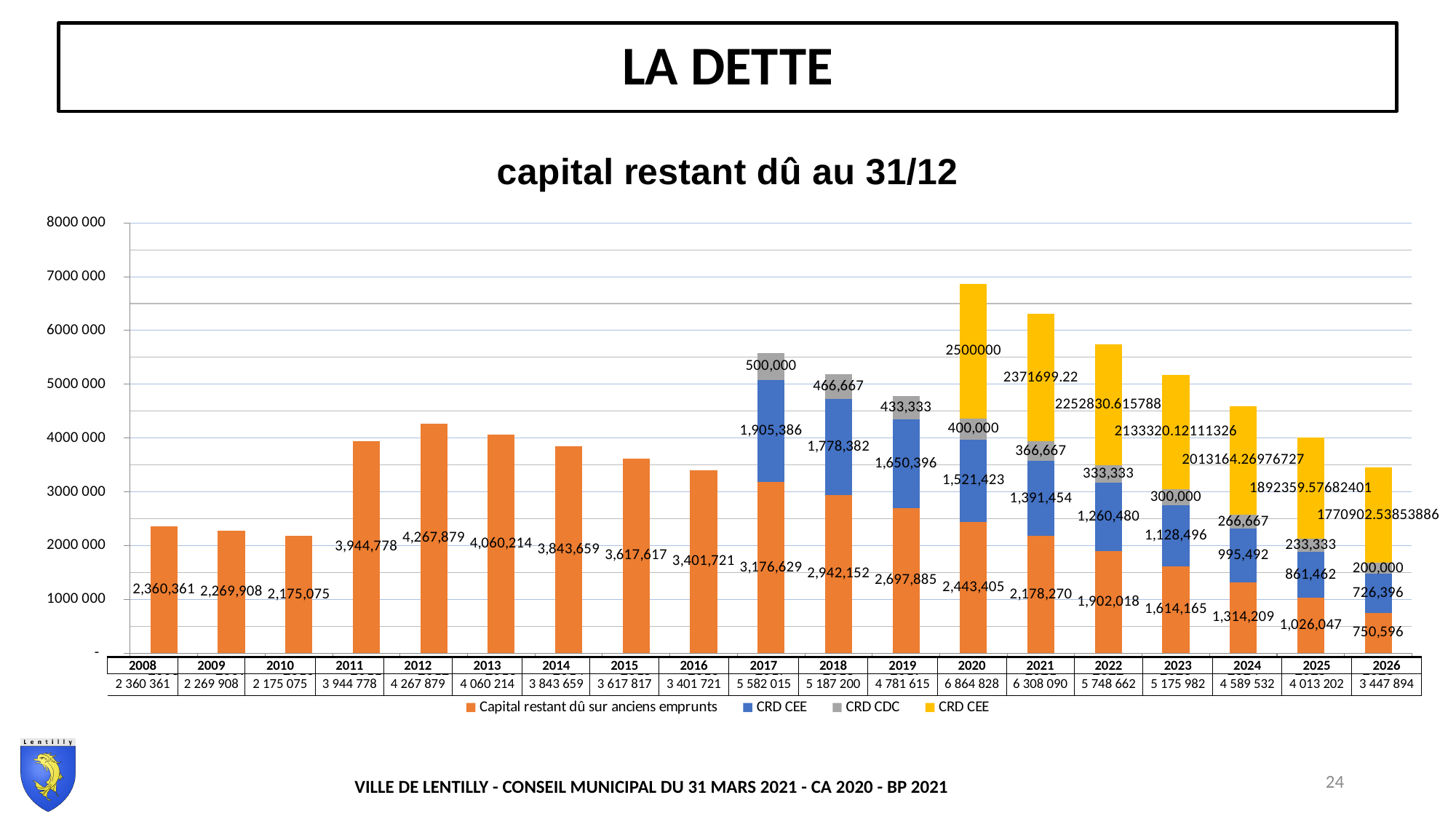
What is the total capital restant dû for 2020, as shown in the data table? 6 864 828 Which year has the lowest total capital restant dû? 2010 What is the value of 'Capital restant dû sur anciens emprunts' for 2012? 4,267,879 Which year has the highest total capital restant dû? 2020 What is the value of 'CRD CDC' for 2018? 466,667 What is the difference between the 'Capital restant dû sur anciens emprunts' values for 2008 and 2009? 90,453 How many years are shown on the x axis of the chart? 19 What kind of chart is shown on the slide? stacked bar chart Do the total values rise or fall from 2020 to 2026? fall How many series does the legend list? 4 What is the title of the chart? capital restant dû au 31/12 What is the value of the blue 'CRD CEE' series for 2017? 1,905,386